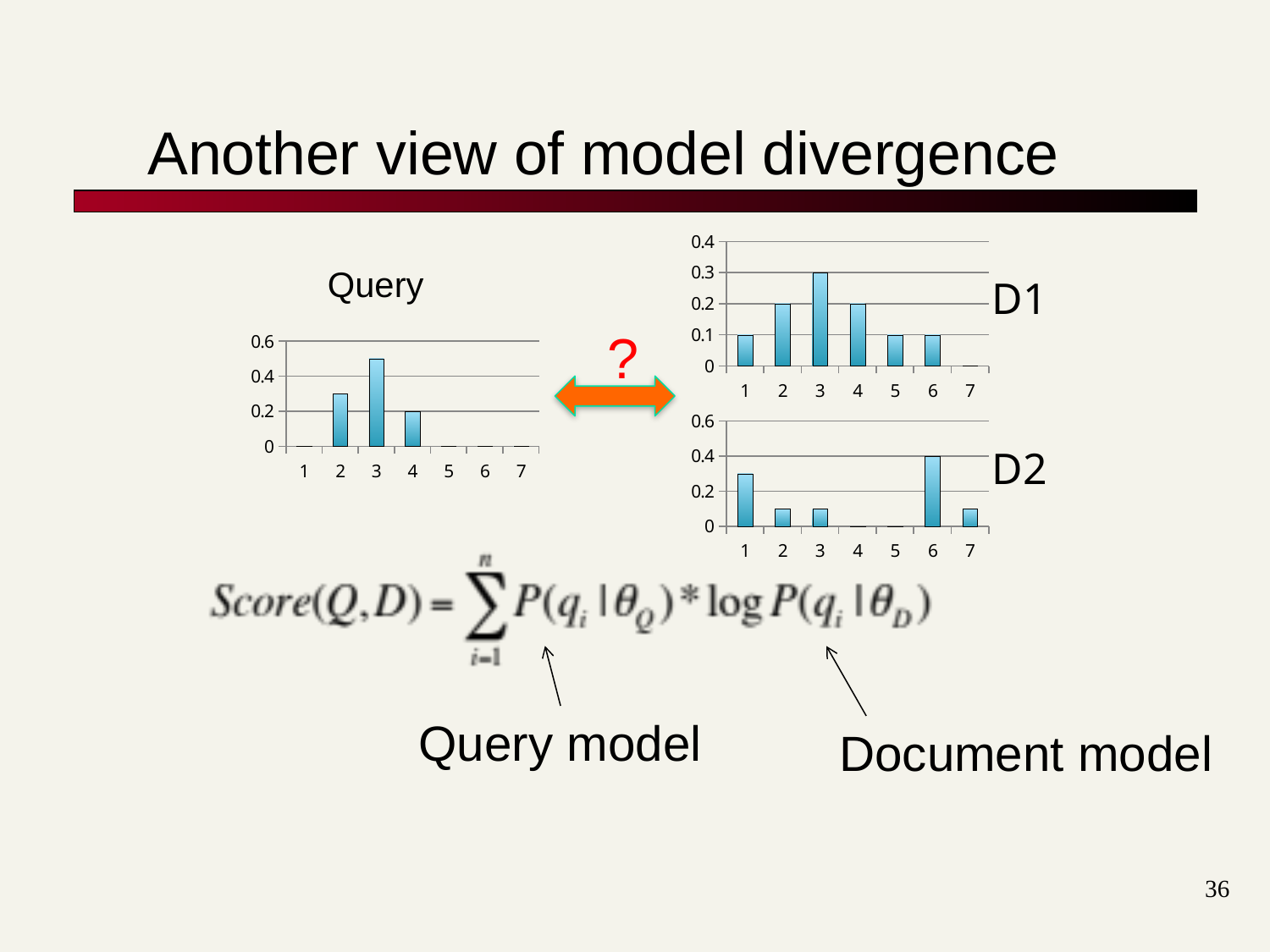
In the D1 chart, what is the difference between the values for category 3 and category 1? 0.2 In the Query chart, what is the value for category 4? 0.2 In the D1 chart, which category has the highest value? 3 In the Query chart, is the value for category 3 greater or less than 0.4? greater In the D2 chart, which category has the highest bar? 6 In the D2 chart, is the value for category 1 greater or less than 0.2? greater How many categories are shown on the x axis of the D1 chart? 7 What kind of chart is the Query chart? bar chart In the D1 chart, what is the value for category 3? 0.3 In the D2 chart, what is the value for category 6? 0.4 In the Query chart, which category has the highest bar? 3 In the D1 chart, what is the value for category 2? 0.2